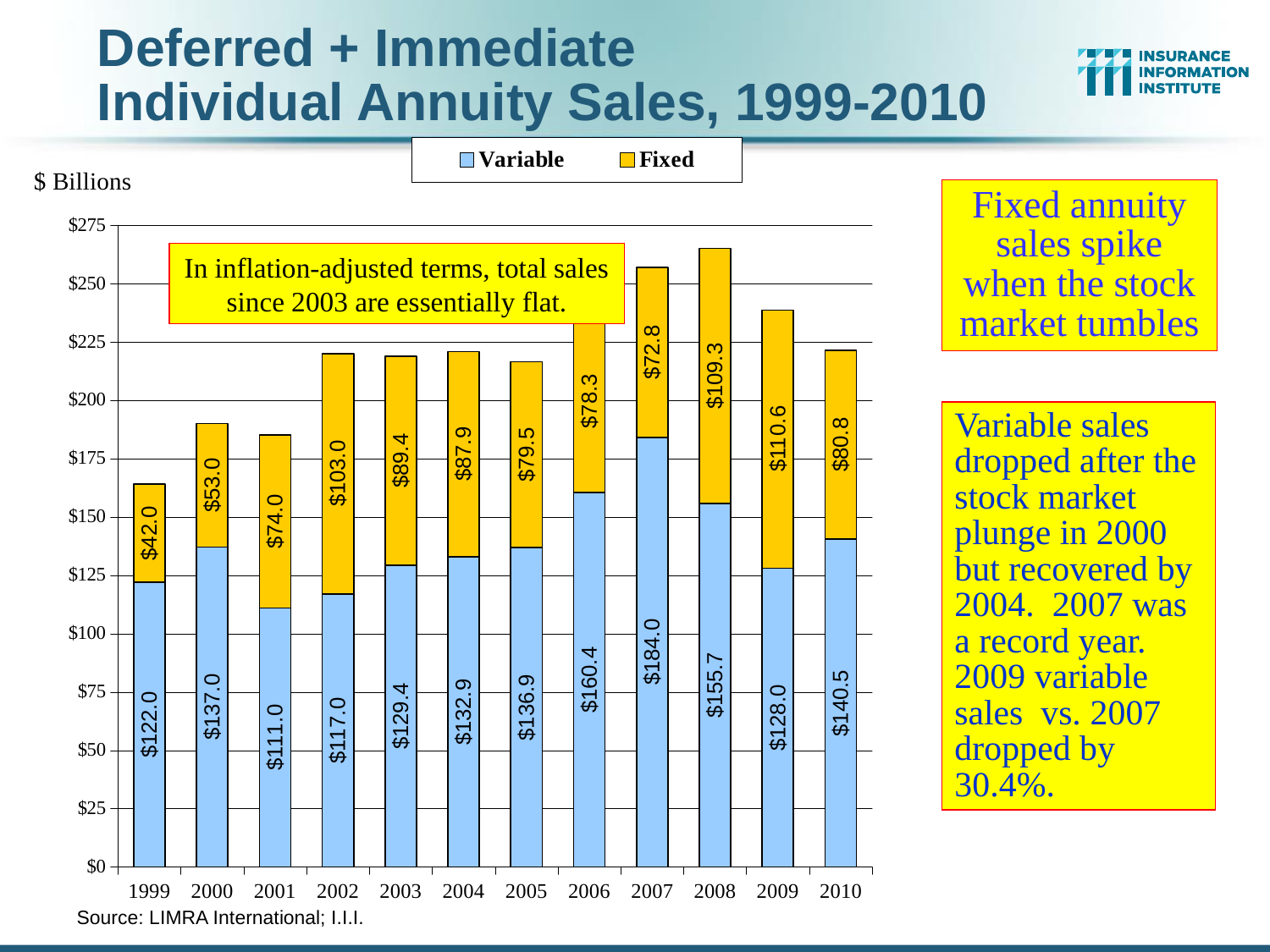
Which year had the lowest fixed annuity sales? 1999 What was the total of variable and fixed annuity sales in 2008? $265.0 How many series does the legend list? 2 What kind of chart is shown? Stacked bar chart Which colour represents fixed annuity sales? Yellow/orange Which year had the highest variable annuity sales? 2007 What were fixed annuity sales in 2009? $110.6 What were variable annuity sales in 2001? $111.0 How many years are shown on the x axis? 12 Which was larger in 2008: variable sales or fixed sales? Variable What were variable annuity sales in 2007? $184.0 What is the difference between variable annuity sales in 2007 and 2009? $56.0